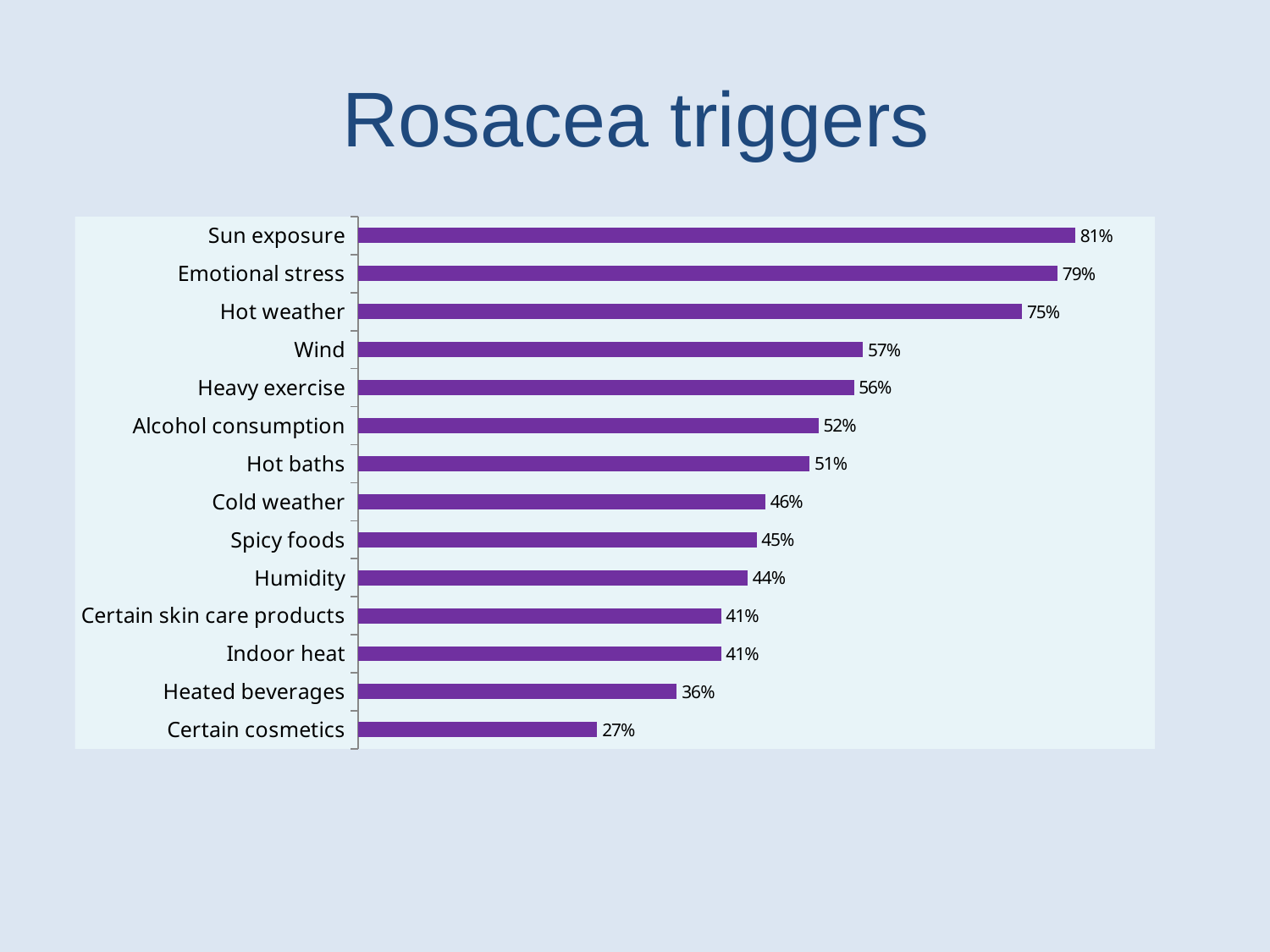
What is the difference between the values for Hot weather and Wind? 18% What is the title of the slide? Rosacea triggers Which is larger, the value for Cold weather or the value for Humidity? Cold weather What is the value for Hot baths? 51% Which trigger has the highest value? Sun exposure What is the value for Heated beverages? 36% How many triggers are shown in the chart? 14 What kind of chart is shown on the slide? Bar chart What is the difference between the values for Sun exposure and Certain cosmetics? 54% What is the value for Sun exposure? 81% Which is larger, the value for Emotional stress or the value for Heavy exercise? Emotional stress Which trigger has the lowest value? Certain cosmetics